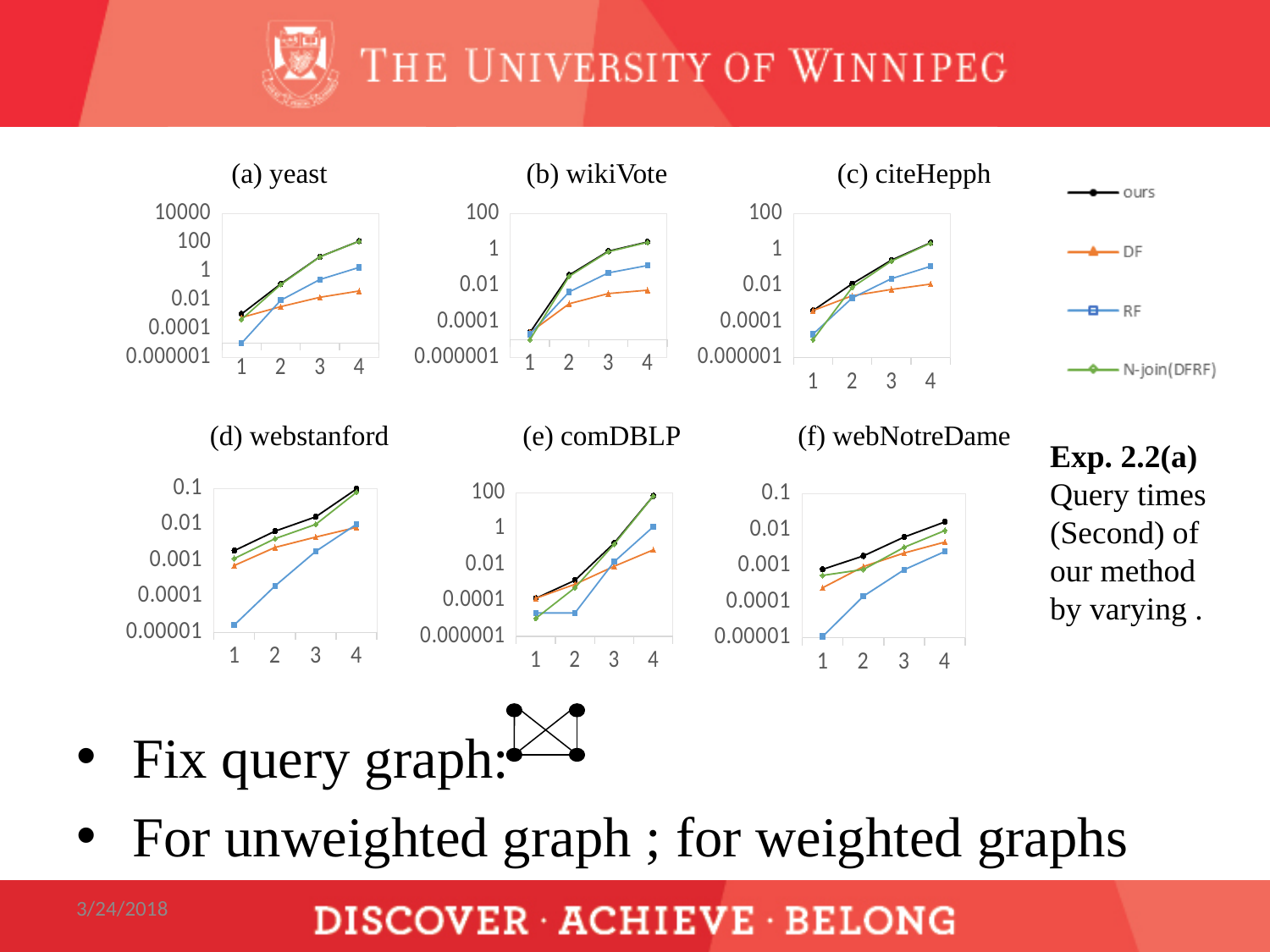
What kind of chart is the (a) yeast chart? line chart How many series does the legend list? 4 What is the title of the chart in the top-right position (third chart in the top row)? (c) citeHepph In the (a) yeast chart, do the values for the 'ours' series rise or fall as x goes from 1 to 4? rise In the (a) yeast chart, which series has the lowest value at x = 1? RF In the (f) webNotreDame chart, does the RF series rise or fall along the x axis? rise How many x-axis points are plotted in the (d) webstanford chart? 4 In the (b) wikiVote chart, is the value for 'ours' at x = 1 greater or less than 0.0001? less In the (d) webstanford chart, which is larger at x = 1, the value for 'ours' or the value for RF? ours In the (f) webNotreDame chart, is the value for 'ours' at x = 4 greater or less than 0.01? greater Which series is shown with a green line in the legend? N-join(DFRF) In the (d) webstanford chart, is the value for RF at x = 1 greater or less than 0.0001? less